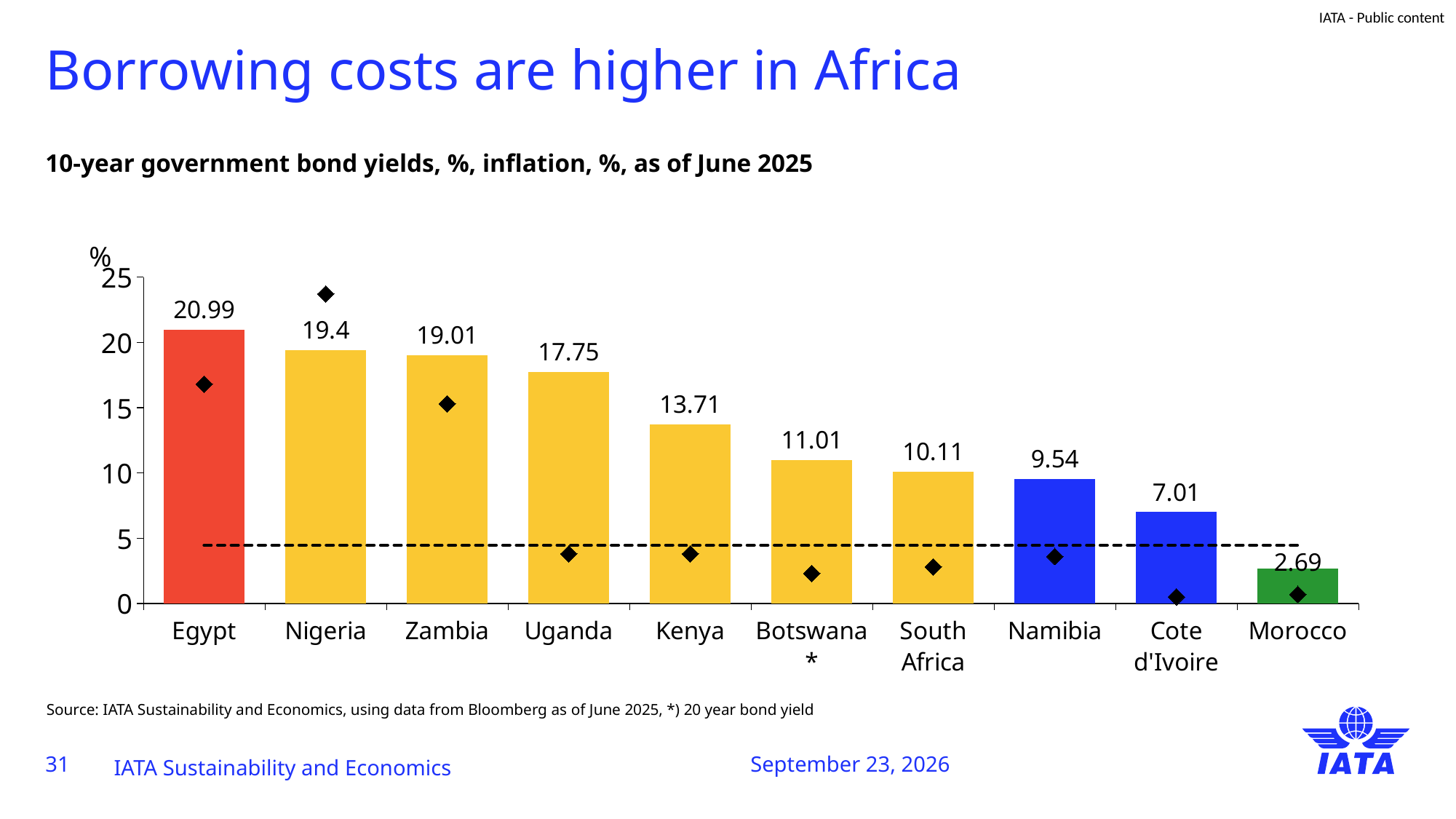
Is the inflation diamond marker for Nigeria greater or less than 20? greater Which country has the highest bond yield bar? Egypt What is the bond yield value labelled for Namibia? 9.54 What is the 10-year government bond yield shown for Egypt? 20.99 What is the bond yield value labelled for Morocco? 2.69 What is the bond yield value labelled for Nigeria? 19.4 Do the bond yield bars rise or fall from left to right along the x axis? fall How many countries are shown on the x axis? 10 What is the difference between the bond yields of Egypt and Nigeria? 1.59 Which country has the lowest bond yield bar? Morocco Which has a higher bond yield, Zambia or Uganda? Zambia What is the difference between the bond yields of Uganda and Kenya? 4.04